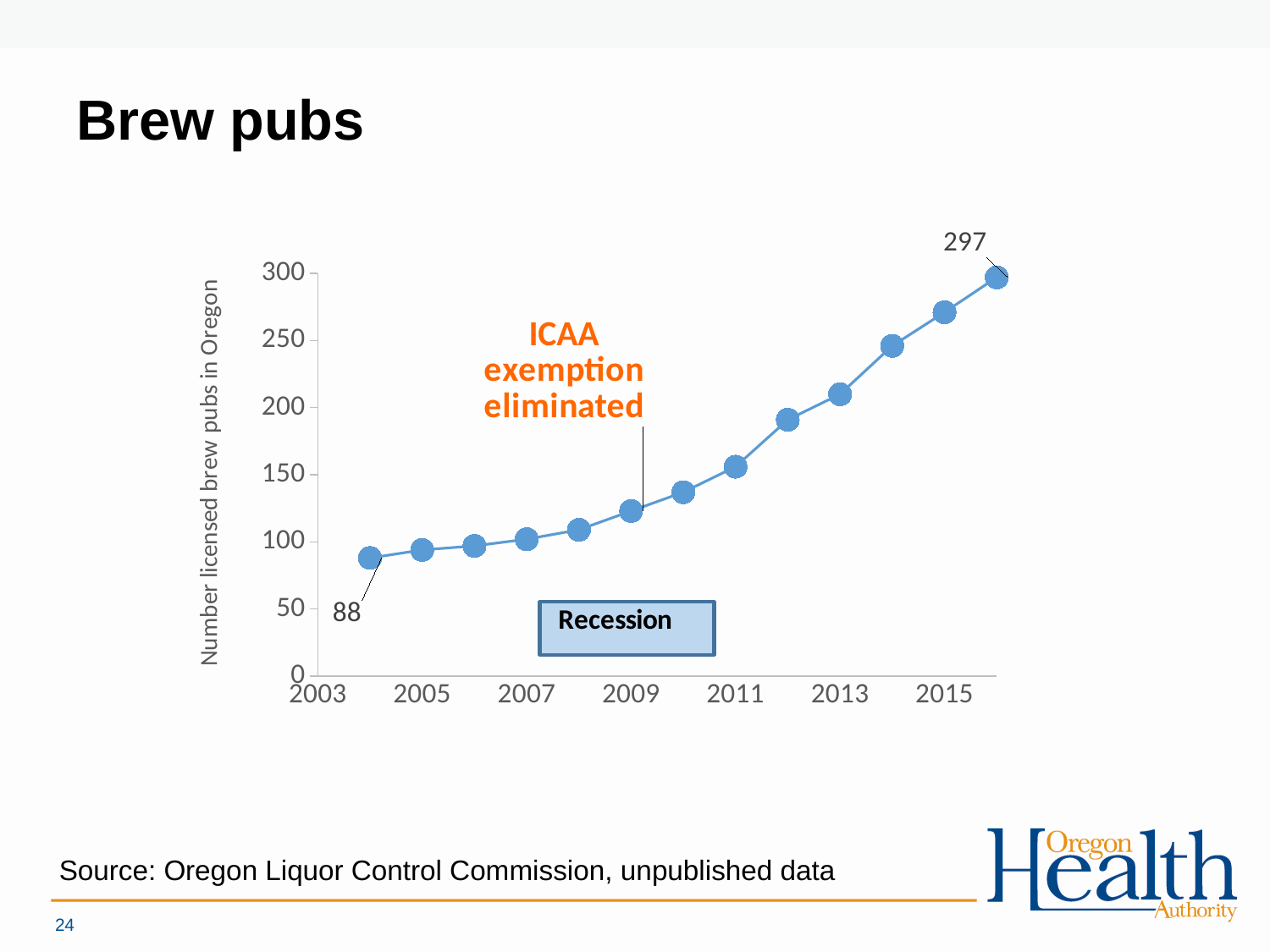
What is the number of licensed brew pubs in Oregon at the first plotted point (2004)? 88 What event does the orange annotation on the chart mark? ICAA exemption eliminated How many data points are plotted on the line? 13 In which year is the number of licensed brew pubs lowest? 2004 What is the number of licensed brew pubs in Oregon at the last plotted point (2016)? 297 Is the value for 2013 greater or less than 200? greater Is the value for 2009 greater or less than 150? less By how much did the number of licensed brew pubs increase between the first labeled point (88) and the last labeled point (297)? 209 In which year is the number of licensed brew pubs highest? 2016 Is the value for 2015 greater or less than 250? greater What kind of chart is shown on the slide? Line chart Do the values rise or fall over time along the x axis? Rise